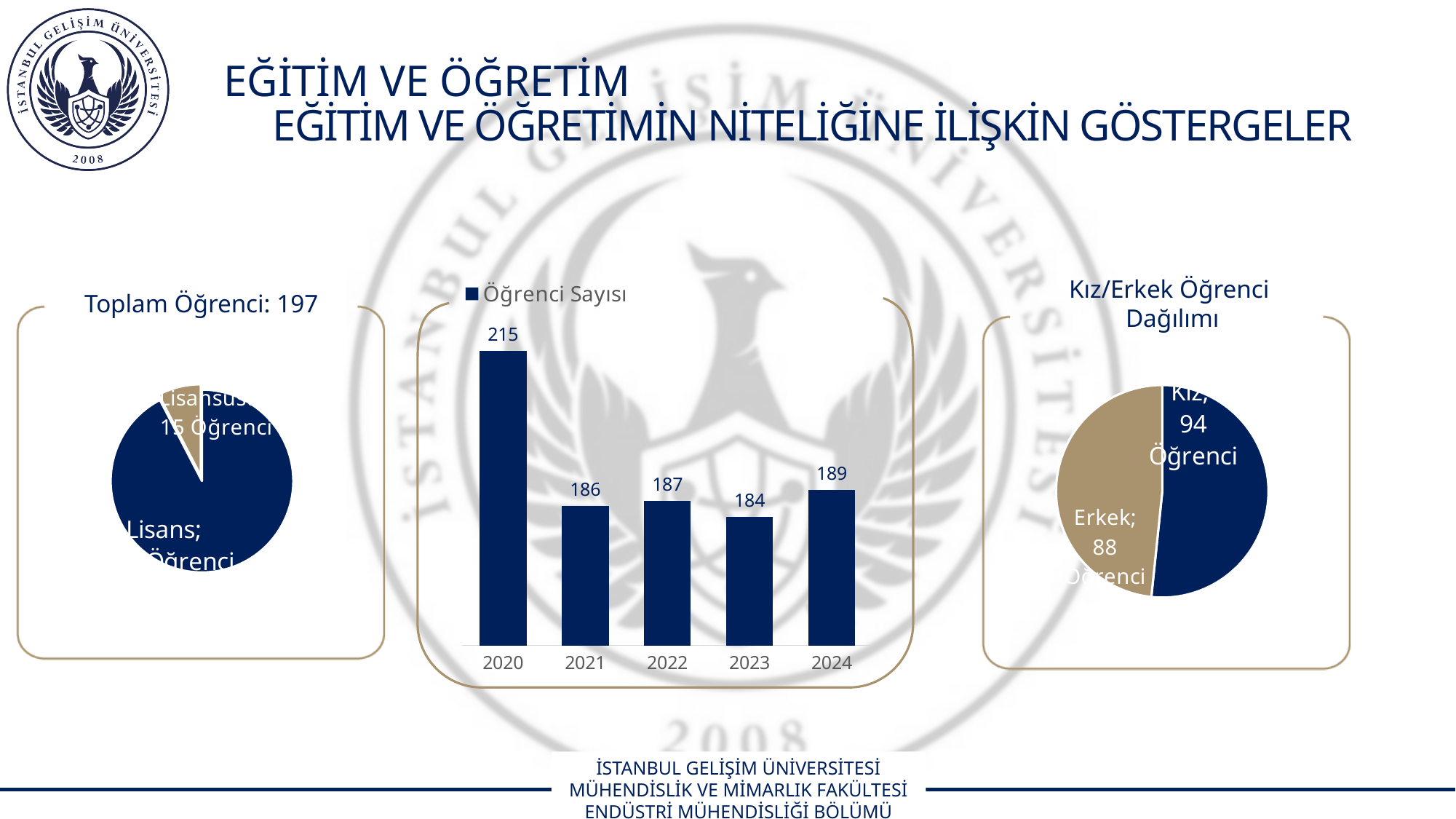
In the middle bar chart (Öğrenci Sayısı), which year has the highest value? 2020 In the middle bar chart (Öğrenci Sayısı), what is the value for 2023? 184 In the left pie chart (Toplam Öğrenci: 197), which slice is larger, Lisans or Lisansüstü? Lisans In the right pie chart (Kız/Erkek Öğrenci Dağılımı), what is the difference between the Kız and Erkek values? 6 In the middle bar chart (Öğrenci Sayısı), what is the value for 2020? 215 What kind of chart is the middle chart titled Öğrenci Sayısı? bar chart In the right pie chart (Kız/Erkek Öğrenci Dağılımı), how many students are in the Kız slice? 94 Öğrenci In the middle bar chart (Öğrenci Sayısı), what is the difference between the values for 2020 and 2021? 29 In the middle bar chart (Öğrenci Sayısı), how many series does the legend list? 1 In the middle bar chart (Öğrenci Sayısı), which is larger, the value for 2022 or the value for 2024? 2024 In the middle bar chart (Öğrenci Sayısı), how many years are shown on the x axis? 5 In the middle bar chart (Öğrenci Sayısı), which year has the lowest value? 2023